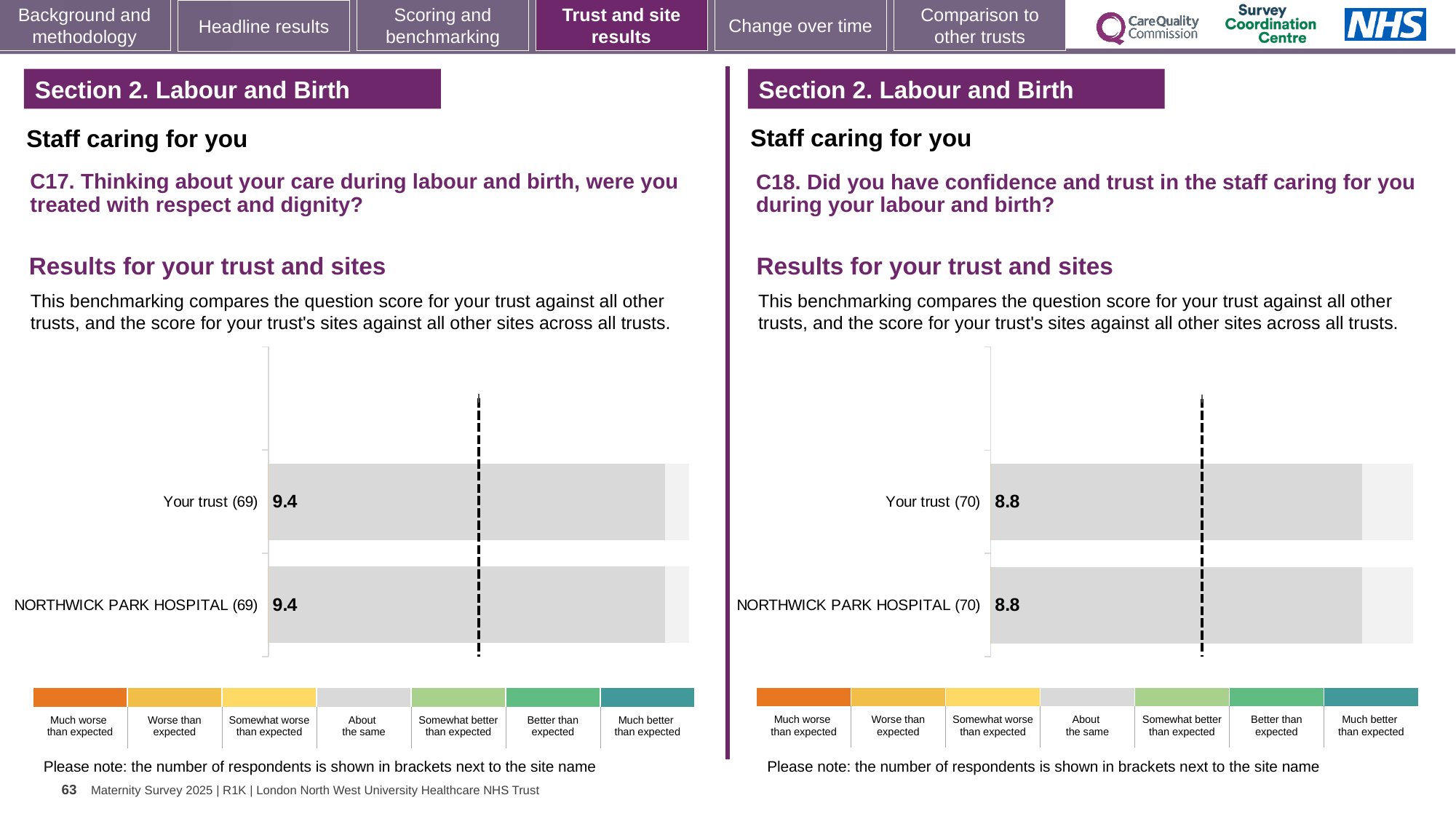
In the right chart (C18), what is the score for Your trust? 8.8 How many respondents are shown in brackets for NORTHWICK PARK HOSPITAL in the left chart (C17)? 69 In the left chart (C17), what is the difference between the score for Your trust and the score for NORTHWICK PARK HOSPITAL? 0 In the right chart (C18), what is the score for NORTHWICK PARK HOSPITAL? 8.8 How many bars are plotted in the right chart (C18)? 2 In the left chart (C17), what is the score for NORTHWICK PARK HOSPITAL? 9.4 How many respondents are shown in brackets for Your trust in the right chart (C18)? 70 How many bars are plotted in the left chart (C17)? 2 Is the score for Your trust in the left chart (C17) larger or smaller than the score for Your trust in the right chart (C18)? Larger What kind of chart is used in the left chart (C17)? Bar chart In the left chart (C17), what is the score for Your trust? 9.4 In the right chart (C18), what is the difference between the score for Your trust and the score for NORTHWICK PARK HOSPITAL? 0